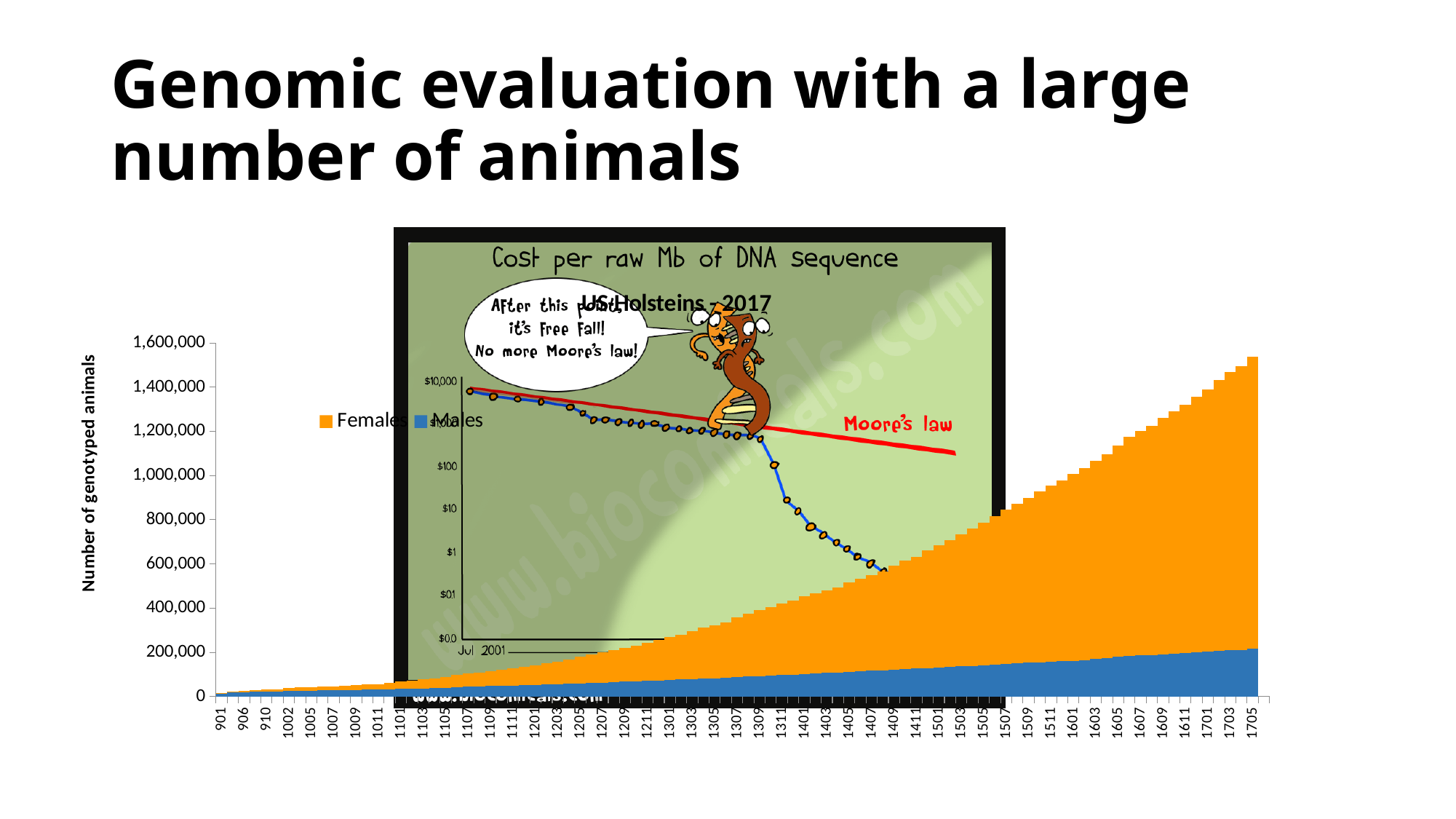
Is the number of genotyped Males at 1705 greater or less than 100,000? greater Do the numbers of genotyped animals rise or fall along the x axis from 901 to 1705? rise Is the total number of genotyped animals at 1301 greater or less than 400,000? less Is the total number of genotyped animals at 1705 greater or less than 1,400,000? greater What are the two series named in the legend of the genotyped animals chart? Females and Males What kind of chart is used to show the number of genotyped animals? bar chart Which series, Females or Males, has the larger number of genotyped animals at 1705? Females At which x-axis category is the total number of genotyped animals highest? 1705 How many series does the legend of the genotyped animals chart list? 2 What is the label on the vertical axis of the genotyped animals chart? Number of genotyped animals